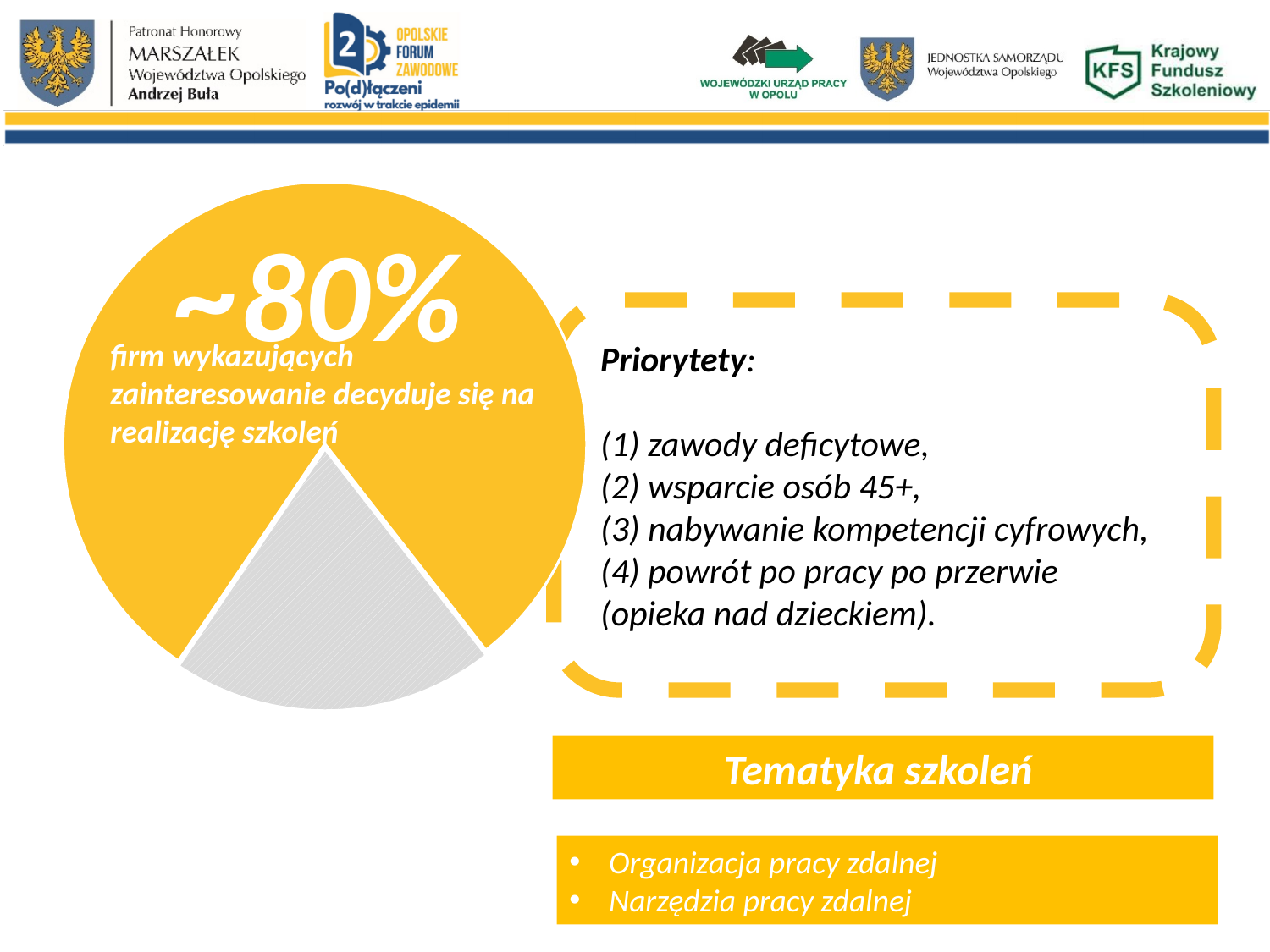
How many slices does the pie chart have? 2 Which slice of the pie chart is larger, the yellow one or the grey one? the yellow one Is the yellow slice of the pie chart greater or less than half of the pie? greater Which slice of the pie chart is the smallest? the grey slice What kind of chart is shown on the left of the slide? pie chart What colour is the larger slice of the pie chart? yellow According to the text on the pie chart, what does the highlighted share refer to? firm wykazujących zainteresowanie decyduje się na realizację szkoleń